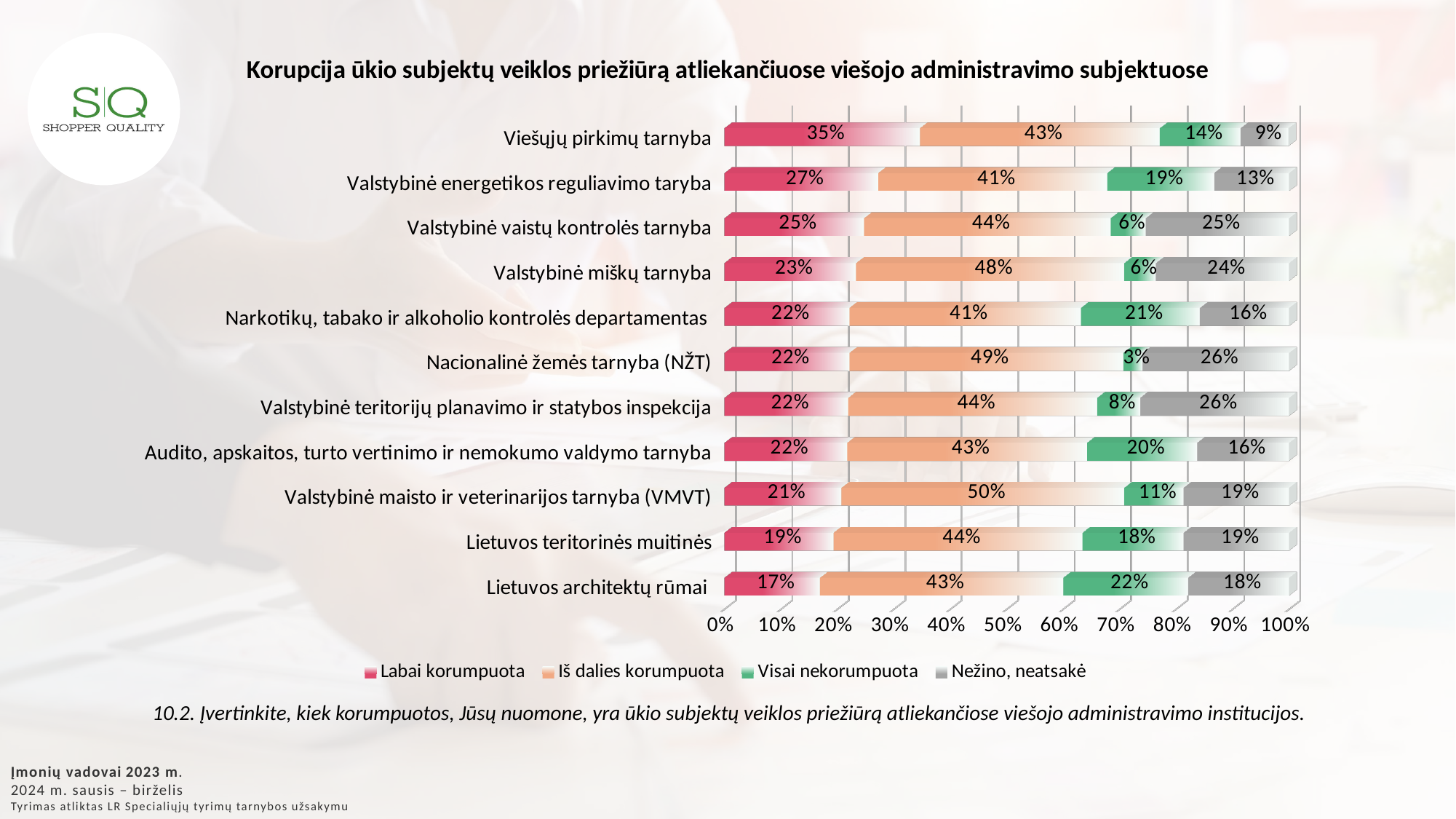
Which institution has the highest 'Labai korumpuota' value? Viešųjų pirkimų tarnyba Which institution has the lowest 'Visai nekorumpuota' value? Nacionalinė žemės tarnyba (NŽT) Which legend entry is shown in green? Visai nekorumpuota How many series does the legend list? 4 What is the 'Iš dalies korumpuota' value for Valstybinė maisto ir veterinarijos tarnyba (VMVT)? 50% How many institutions (categories) are listed on the chart? 11 What is the 'Labai korumpuota' value for Viešųjų pirkimų tarnyba? 35% What kind of chart is shown on the slide? Stacked bar chart Which institution has the lowest 'Labai korumpuota' value? Lietuvos architektų rūmai What is the 'Nežino, neatsakė' value for Valstybinė energetikos reguliavimo taryba? 13% Which is larger: the 'Visai nekorumpuota' value for Narkotikų, tabako ir alkoholio kontrolės departamentas or for Valstybinė miškų tarnyba? Narkotikų, tabako ir alkoholio kontrolės departamentas What is the difference between the 'Labai korumpuota' values for Viešųjų pirkimų tarnyba and Lietuvos architektų rūmai? 18%